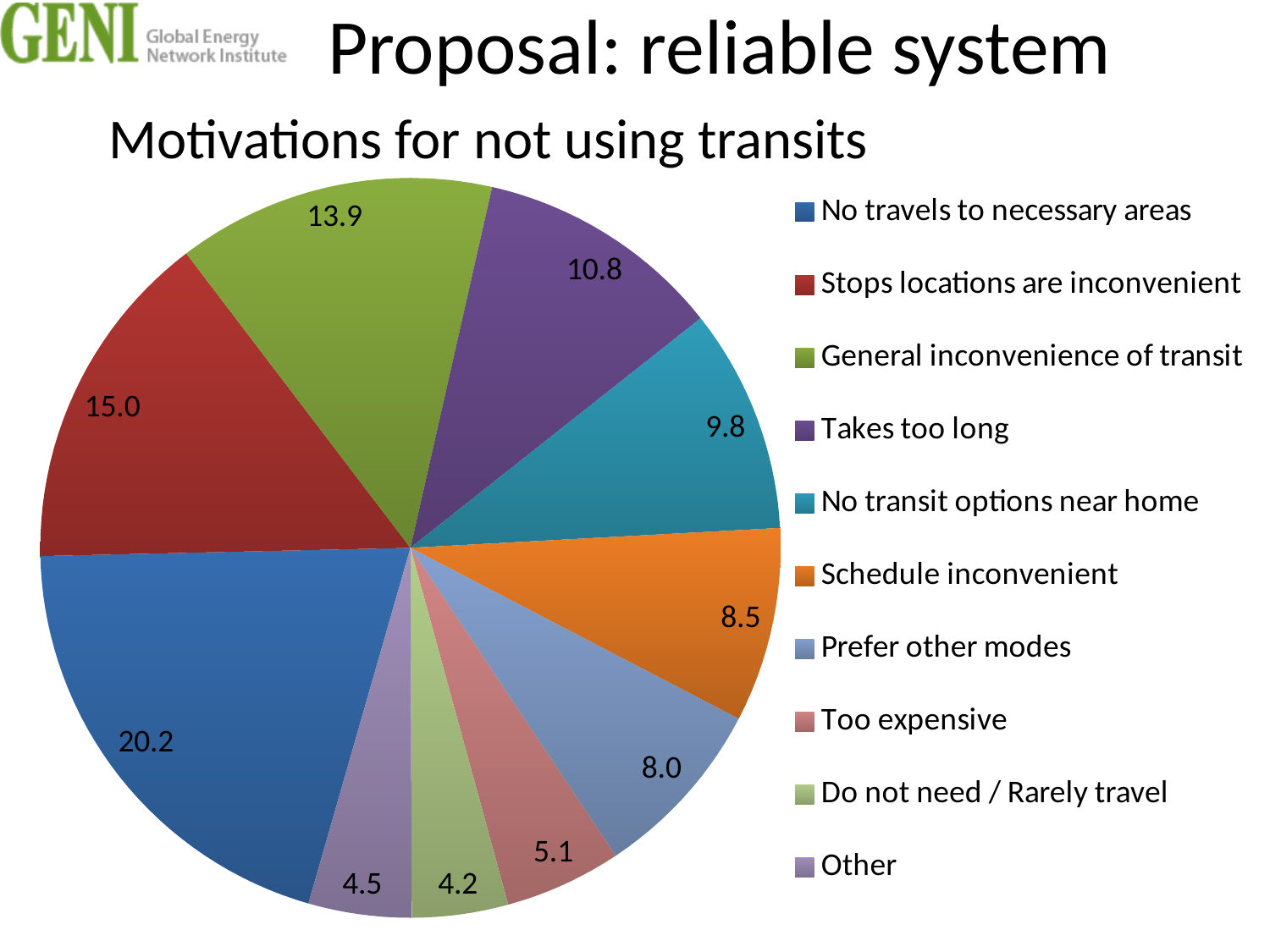
What is the title of the chart? Motivations for not using transits Which is larger, the value for "No transit options near home" or the value for "Prefer other modes"? No transit options near home What is the value for "No travels to necessary areas"? 20.2 How many categories does the pie chart show? 10 Which category has the smallest slice of the pie? Do not need / Rarely travel Which category is shown in orange in the legend? Schedule inconvenient What is the value for "Takes too long"? 10.8 Which category has the largest slice of the pie? No travels to necessary areas What is the difference between the values for "Too expensive" and "Other"? 0.6 What is the difference between the values for "Stops locations are inconvenient" and "General inconvenience of transit"? 1.1 What is the value for "Schedule inconvenient"? 8.5 What type of chart is shown on the slide? Pie chart